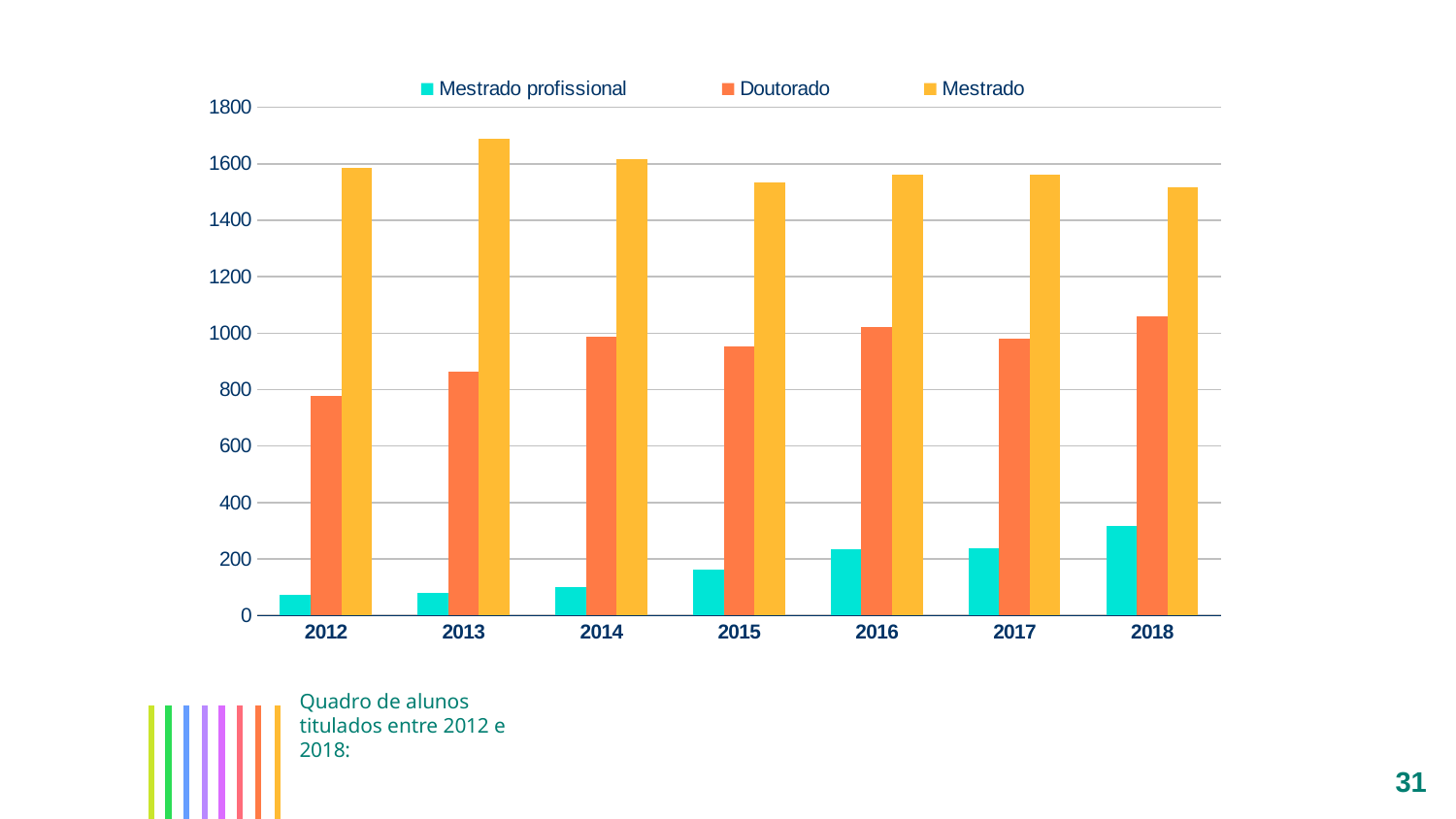
Is the Doutorado value for 2012 greater or less than 800? less Which is larger, the Doutorado value for 2013 or for 2014? 2014 Does the Mestrado profissional series generally rise or fall from 2012 to 2018? rise In which year is the Doutorado value lowest? 2012 Is the Mestrado value for 2013 greater or less than 1600? greater How many series does the legend list? 3 In which year is the Mestrado profissional value highest? 2018 What kind of chart is shown on the slide? bar chart In which year is the Mestrado value highest? 2013 How many years are shown on the x axis? 7 Which series is shown in orange? Doutorado